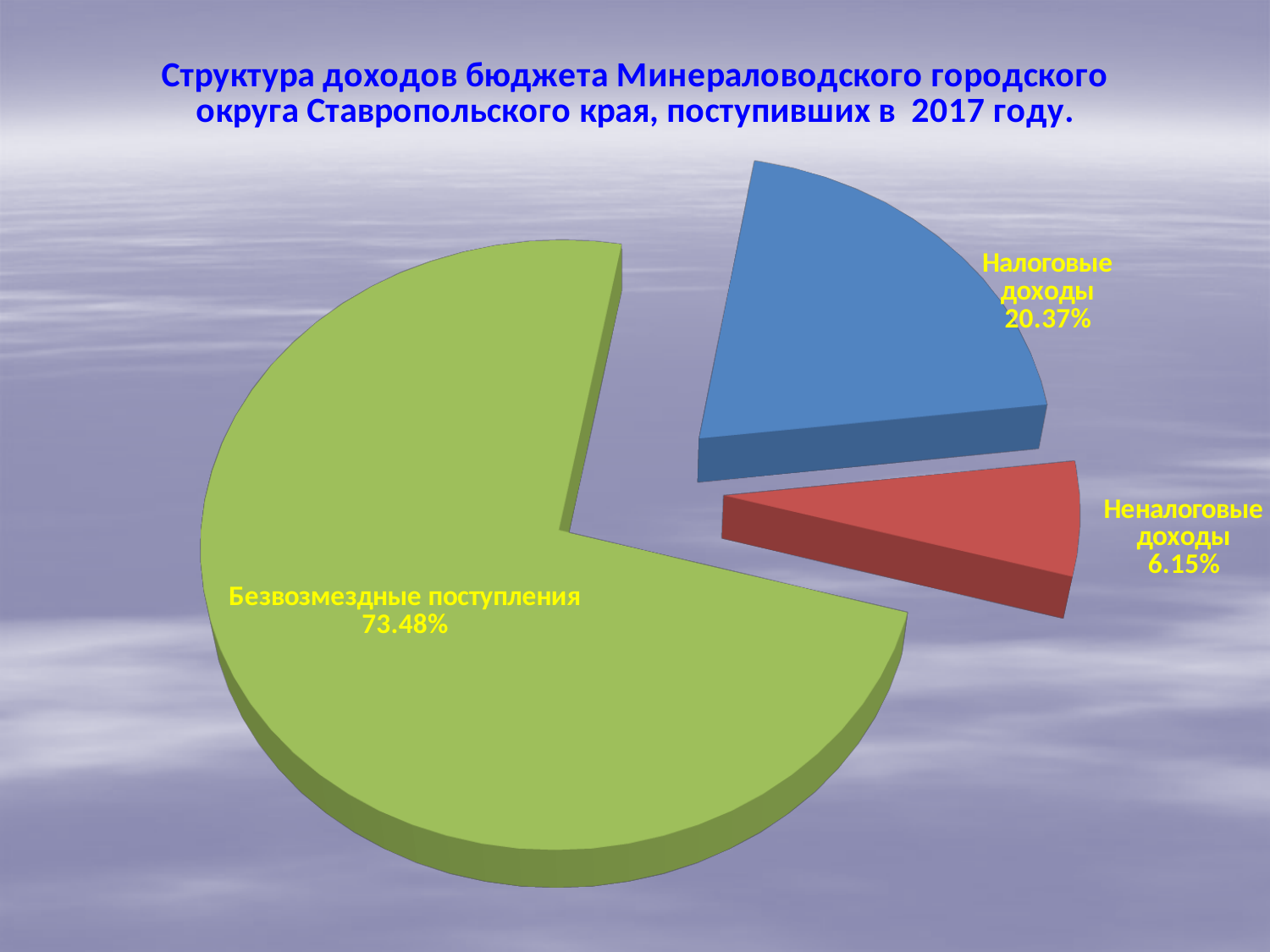
Which year does the chart title say the budget revenues were received in? 2017 What is the difference in percentage points between Налоговые доходы and Неналоговые доходы? 14.22 What share of the pie is labelled for Налоговые доходы? 20.37% What is the difference in percentage points between Безвозмездные поступления and Налоговые доходы? 53.11 What share of the pie is labelled for Неналоговые доходы? 6.15% What colour is the slice for Безвозмездные поступления? green Which category has the largest slice of the pie? Безвозмездные поступления Which is larger: the share for Налоговые доходы or the share for Неналоговые доходы? Налоговые доходы How many slices does the pie chart have? 3 What share of the pie is labelled for Безвозмездные поступления? 73.48% What kind of chart is shown on the slide? pie chart Which category has the smallest slice of the pie? Неналоговые доходы